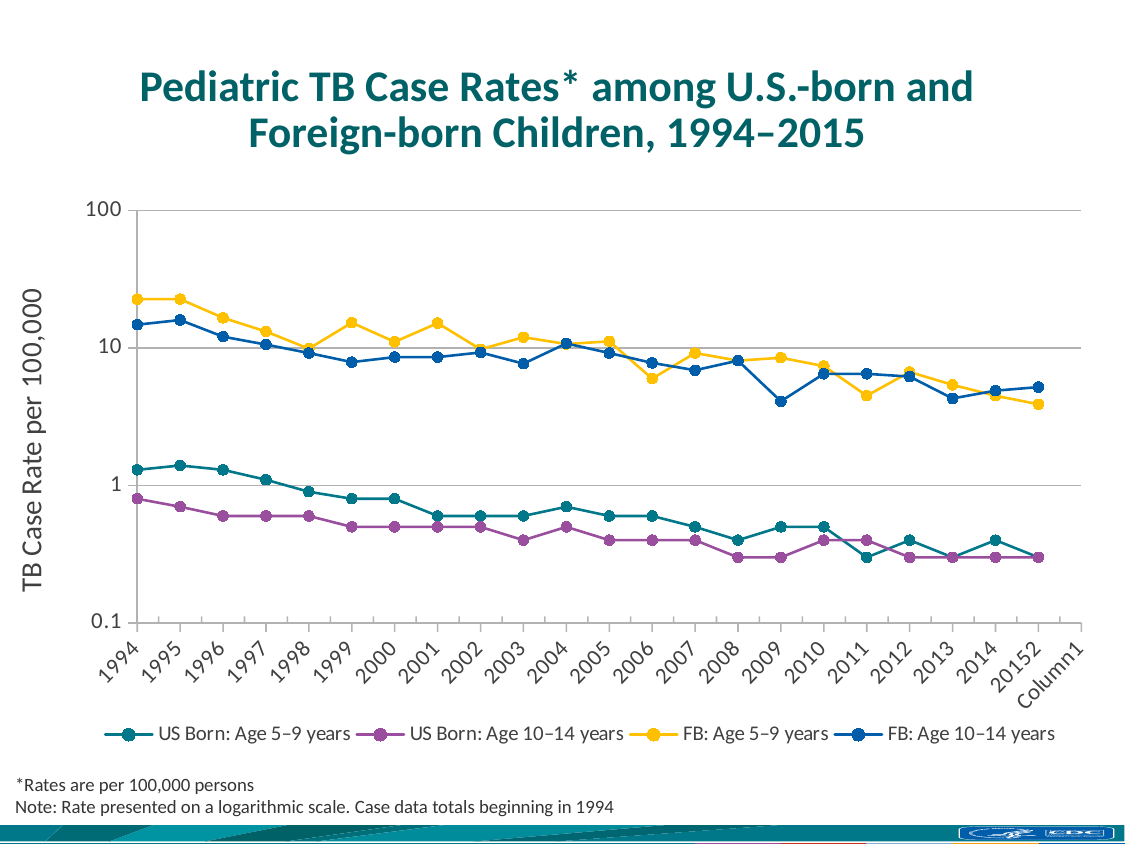
How many series does the legend list? 4 Is the value for US Born: Age 10–14 years in 2015 greater or less than 1? less What kind of chart is shown on the slide? Line chart Does the FB: Age 5–9 years series generally rise or fall from 1994 to 2015? Fall Is the value for US Born: Age 5–9 years in 1995 greater or less than 1? greater Is the value for FB: Age 5–9 years in 1994 greater or less than 10? greater Which series has the highest value in 1994? FB: Age 5–9 years In 2015, which series is higher: FB: Age 5–9 years or FB: Age 10–14 years? FB: Age 10–14 years Which series has the lowest value in 1994? US Born: Age 10–14 years What is the label of the y-axis? TB Case Rate per 100,000 In 1994, which series is higher: FB: Age 5–9 years or FB: Age 10–14 years? FB: Age 5–9 years